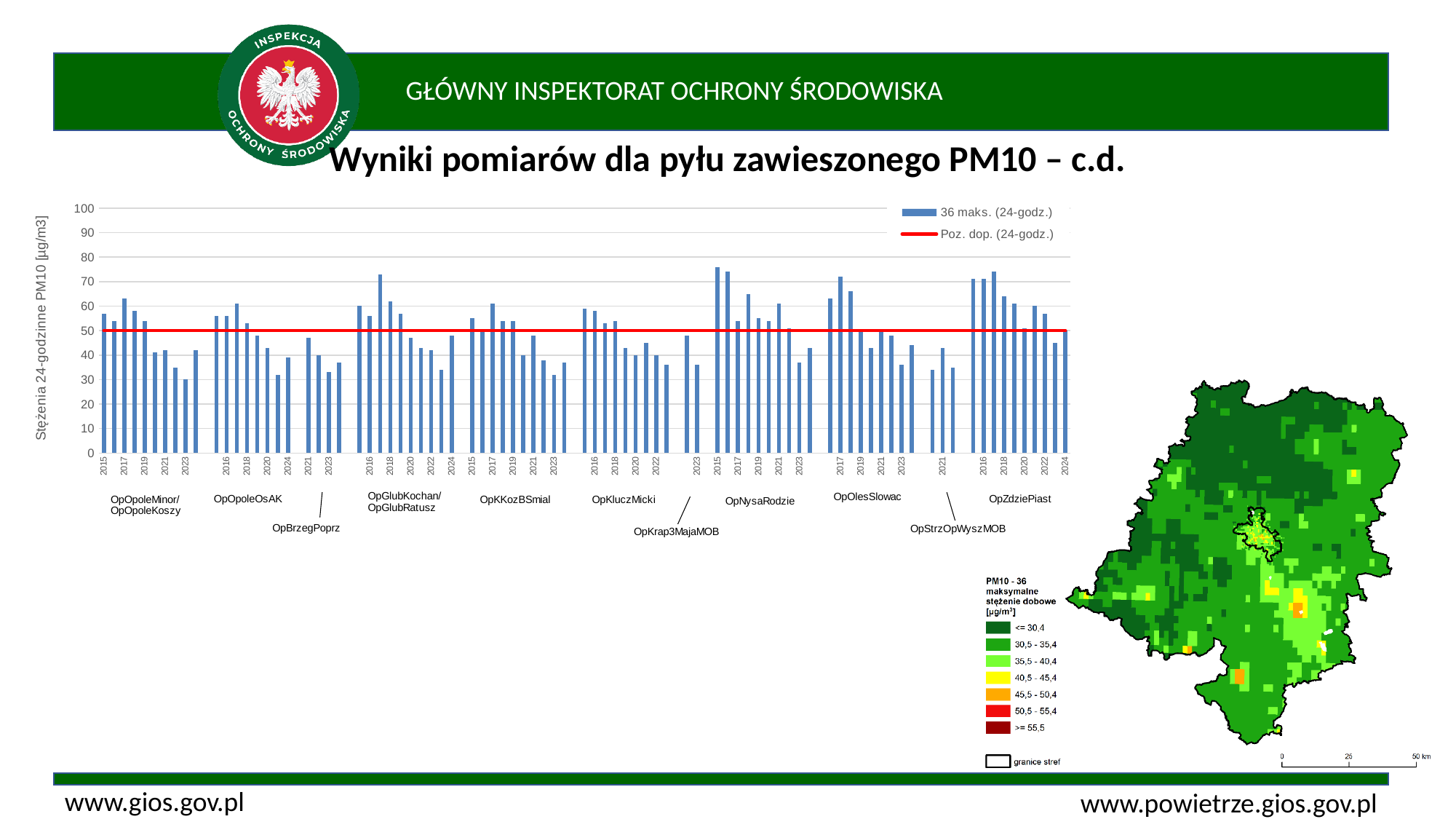
How many series does the chart legend list? 2 At what value on the vertical axis is the red 'Poz. dop. (24-godz.)' line drawn? 50 What are the two entries in the chart legend? 36 maks. (24-godz.) and Poz. dop. (24-godz.) Which is larger: the value for OpNysaRodzie in 2015 or the value for OpOpoleMinor/OpOpoleKoszy in 2015? OpNysaRodzie in 2015 Is the value for OpZdziePiast in 2018 greater or less than 60? greater What is the title of the vertical axis of the chart? Stężenia 24-godzinne PM10 [µg/m3] What kind of chart is shown on the slide? combination bar and line chart Is the value for OpNysaRodzie in 2015 greater or less than 70? greater Is the value for OpOpoleMinor/OpOpoleKoszy in 2023 greater or less than 40? less Do the values for OpOpoleOsAK generally rise or fall from 2016 to 2024? fall